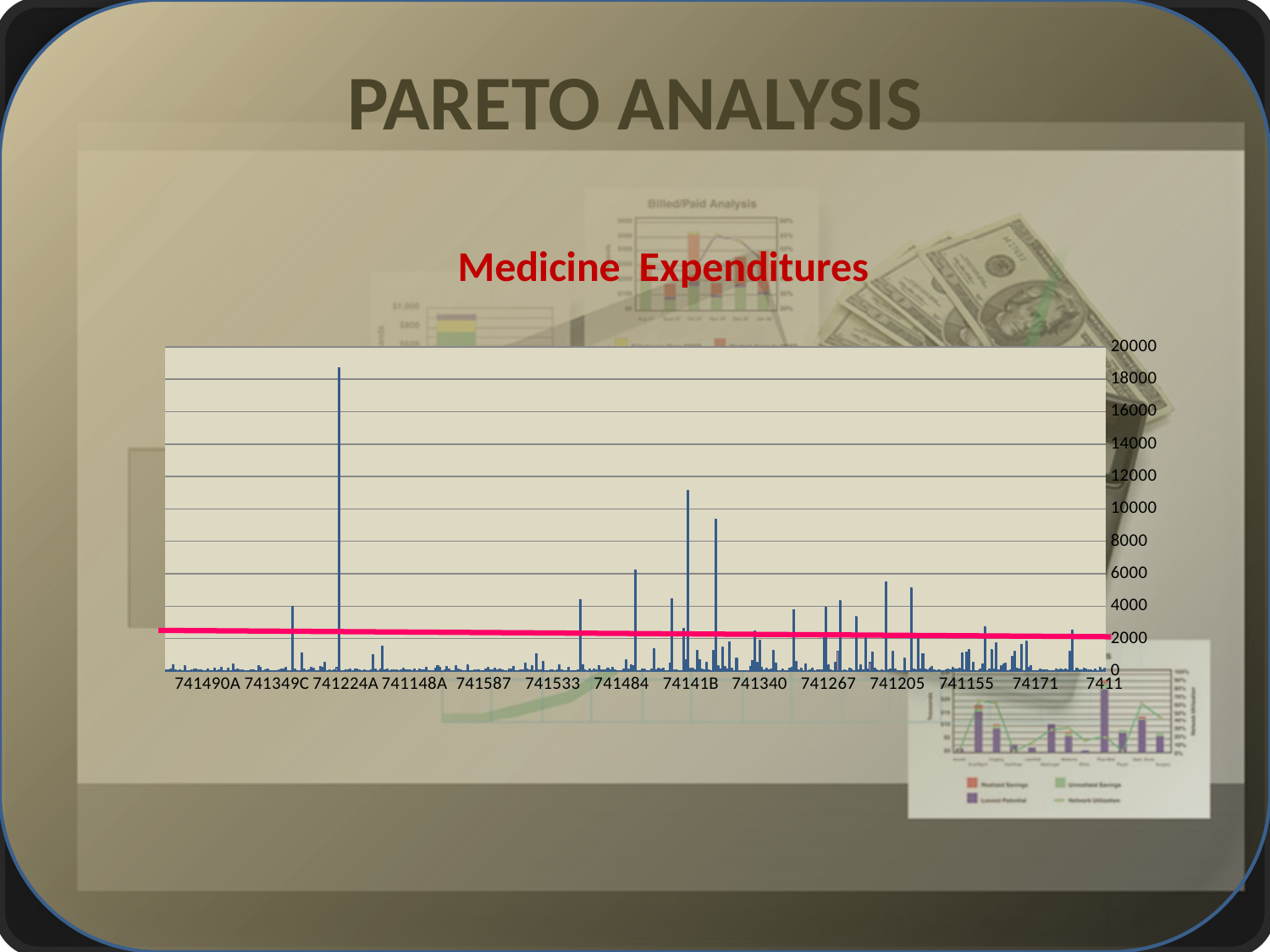
Is the tallest bar in the Medicine Expenditures chart greater or less than 20000? less How many category labels are printed along the horizontal axis of the Medicine Expenditures chart? 14 Which is the first category label printed on the horizontal axis of the Medicine Expenditures chart? 741490A Which is the last category label printed on the horizontal axis of the Medicine Expenditures chart? 7411 Is the second-tallest bar in the Medicine Expenditures chart greater or less than 10000? greater What is the highest value shown on the vertical axis of the Medicine Expenditures chart? 20000 What is the title of the chart on the slide? Medicine Expenditures Is the tallest bar in the Medicine Expenditures chart greater or less than 16000? greater What kind of chart is shown under the heading "Medicine Expenditures"? bar chart